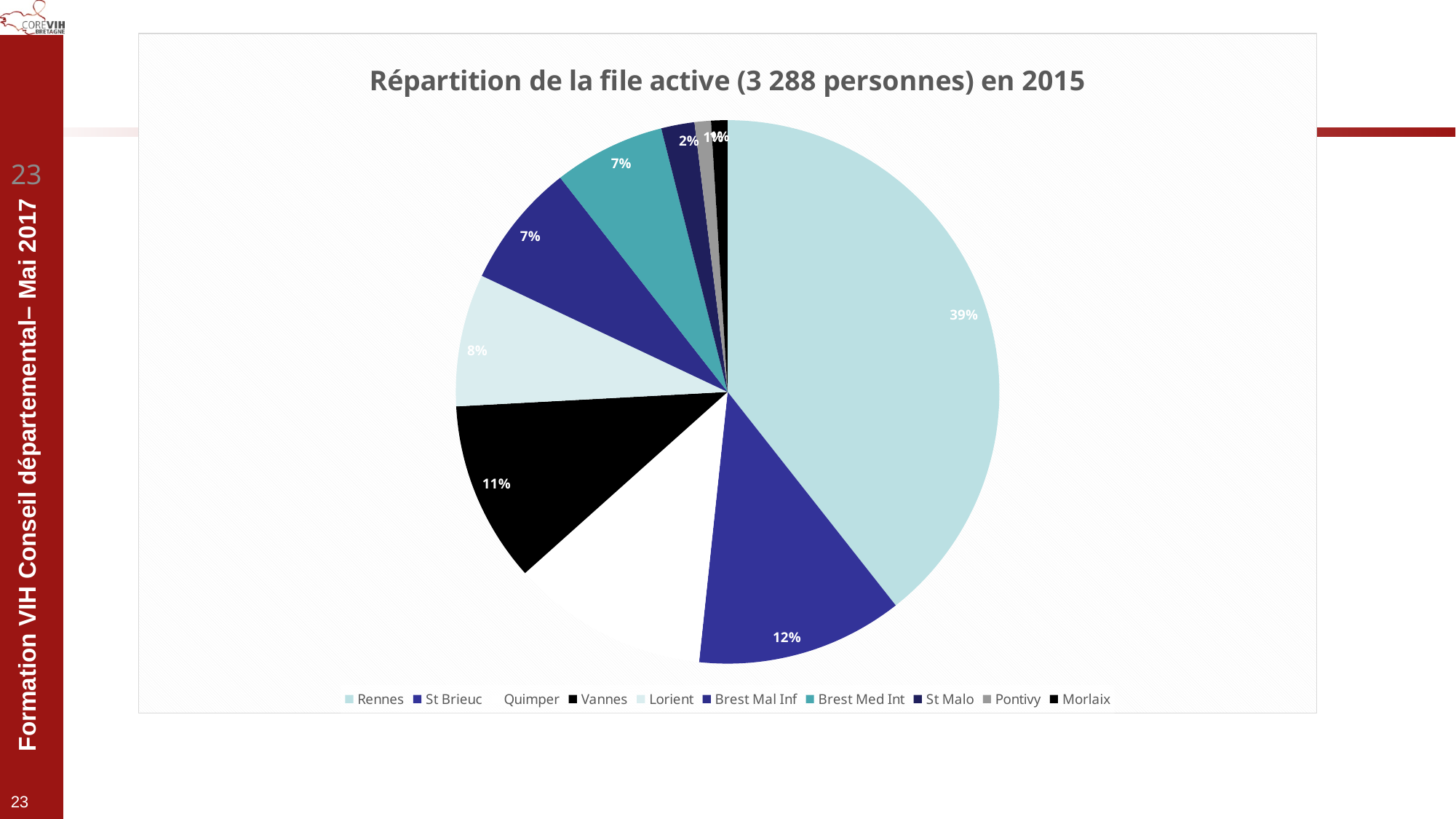
What percentage is shown for St Brieuc? 12% What type of chart is shown on the slide? Pie chart What is the title of the chart? Répartition de la file active (3 288 personnes) en 2015 What percentage is shown for Vannes? 11% What percentage is shown for St Malo? 2% How many sites are listed in the legend? 10 What is the difference in percentage points between Rennes and St Brieuc? 27 percentage points Which site has the largest share of the file active? Rennes Which has a larger share, Vannes or Lorient? Vannes What share does Lorient account for? 8% What share of the file active does Rennes represent? 39% What percentage is shown for Brest Med Int? 7%